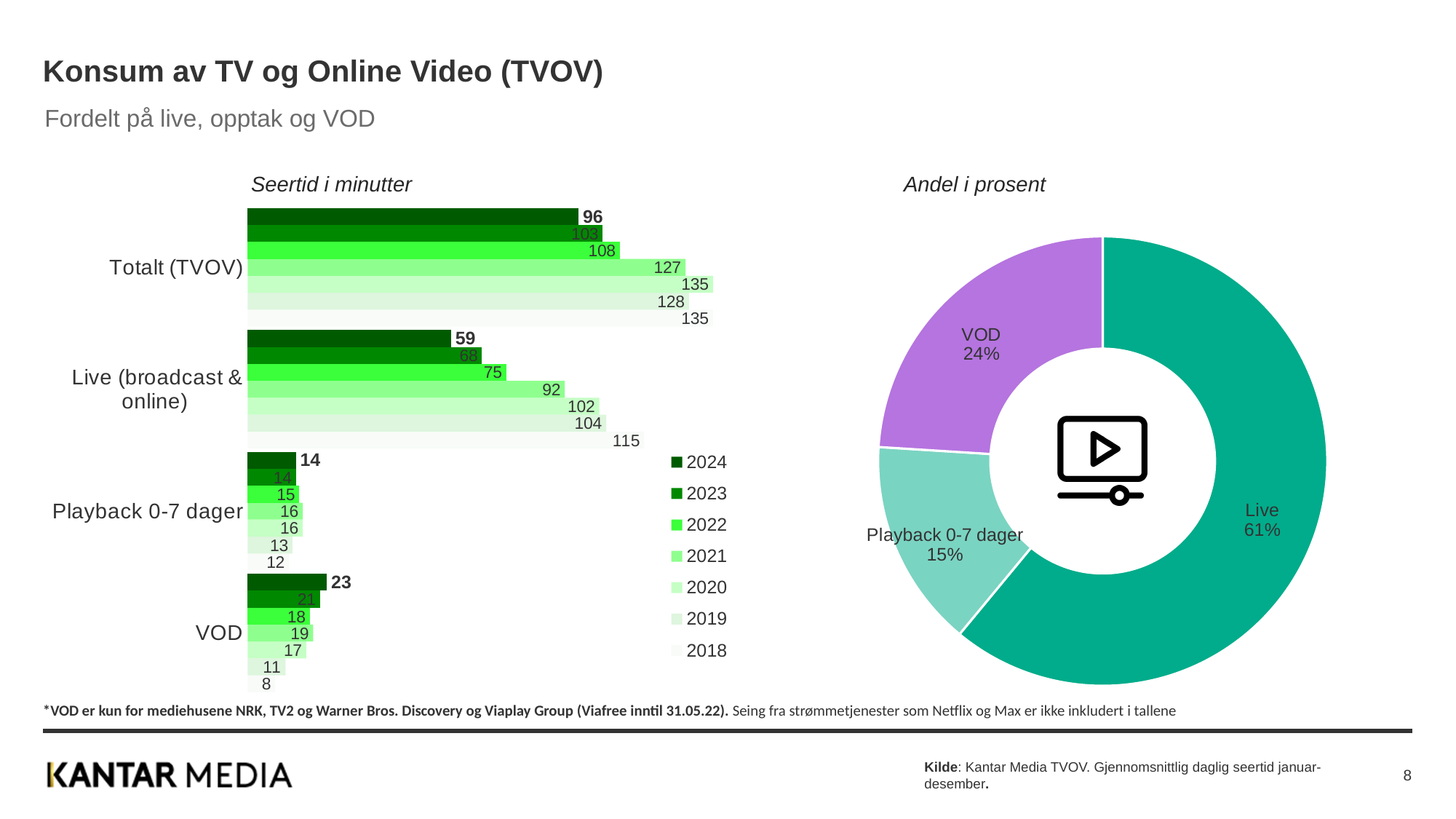
In the 'Seertid i minutter' chart, which is larger for Live (broadcast & online): the 2023 value or the 2022 value? 2022 In the 'Seertid i minutter' chart, what is the 2019 value for Playback 0-7 dager? 13 In the 'Seertid i minutter' chart, what is the 2018 value for Live (broadcast & online)? 115 In the 'Seertid i minutter' chart, what is the 2024 value for VOD? 23 In the 'Seertid i minutter' chart, which year has the lowest value for Live (broadcast & online)? 2024 In the 'Seertid i minutter' chart, do the VOD values rise or fall from 2018 to 2024? rise In the 'Seertid i minutter' chart, what is the difference between the 2018 and 2024 values for Totalt (TVOV)? 39 What kind of chart is the 'Andel i prosent' chart? donut chart In the 'Seertid i minutter' chart, which year has the highest value for VOD? 2024 How many years does the legend of the 'Seertid i minutter' chart list? 7 In the 'Andel i prosent' chart, what share does Live have? 61% In the 'Seertid i minutter' chart, what is the 2024 value for Totalt (TVOV)? 96